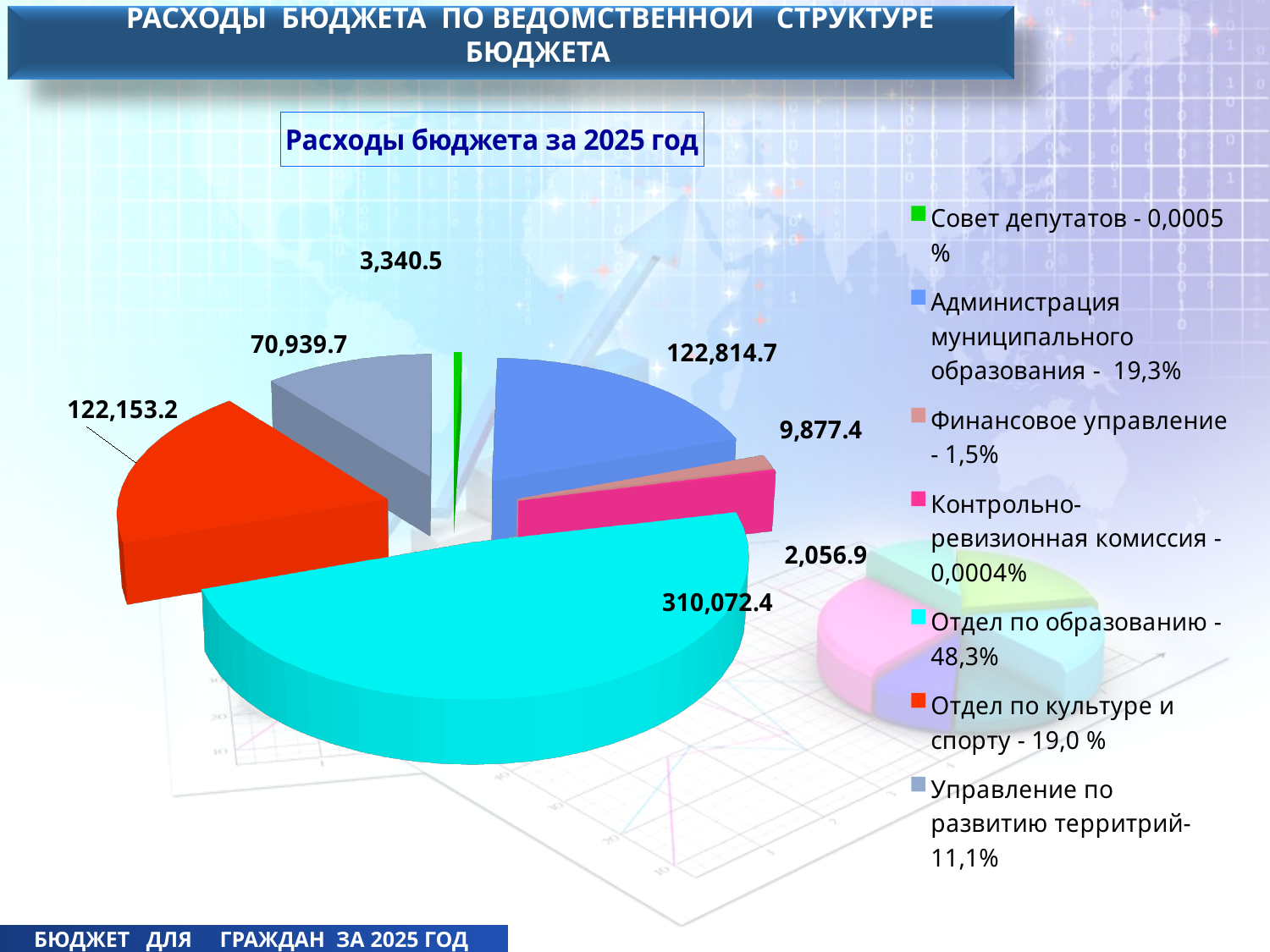
What is the value shown for Администрация муниципального образования? 122,814.7 What is the value shown for Управление по развитию территрий? 70,939.7 What share of the pie does Отдел по образованию have, according to the legend? 48,3% Which is larger: the value for Отдел по образованию or the value for Управление по развитию территрий? Отдел по образованию What is the difference between the values for Администрация муниципального образования and Отдел по культуре и спорту? 661.5 What share of the pie does Администрация муниципального образования have, according to the legend? 19,3% What is the title of the chart? Расходы бюджета за 2025 год What kind of chart is shown on the slide? pie chart What is the value shown for Отдел по образованию? 310,072.4 What is the value shown for Отдел по культуре и спорту? 122,153.2 Which category has the largest slice of the pie? Отдел по образованию How many slices does the pie chart have? 7